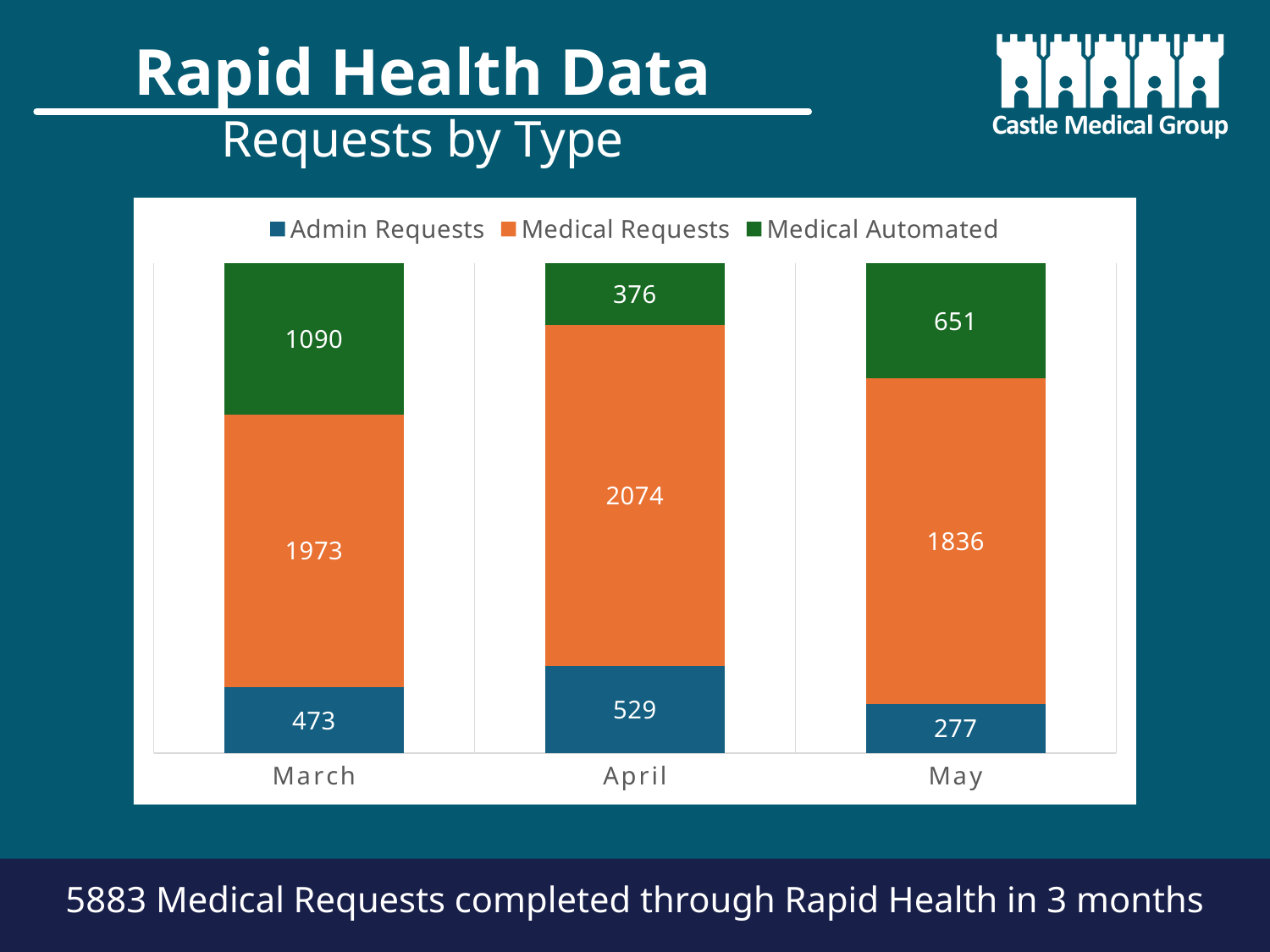
Which month has the highest value for Medical Automated? March What is the value for Medical Requests in April? 2074 What is the value for Medical Automated in March? 1090 How many months are shown on the x axis? 3 What is the value for Admin Requests in May? 277 Which is larger: Admin Requests in March or Admin Requests in April? Admin Requests in April What kind of chart is shown on the slide? Stacked bar chart What is the total of the stacked bar for May? 2764 What is the difference between Medical Requests in April and Medical Requests in May? 238 Which month has the lowest value for Admin Requests? May How many series does the legend list? 3 What is the total of the stacked bar for March? 3536